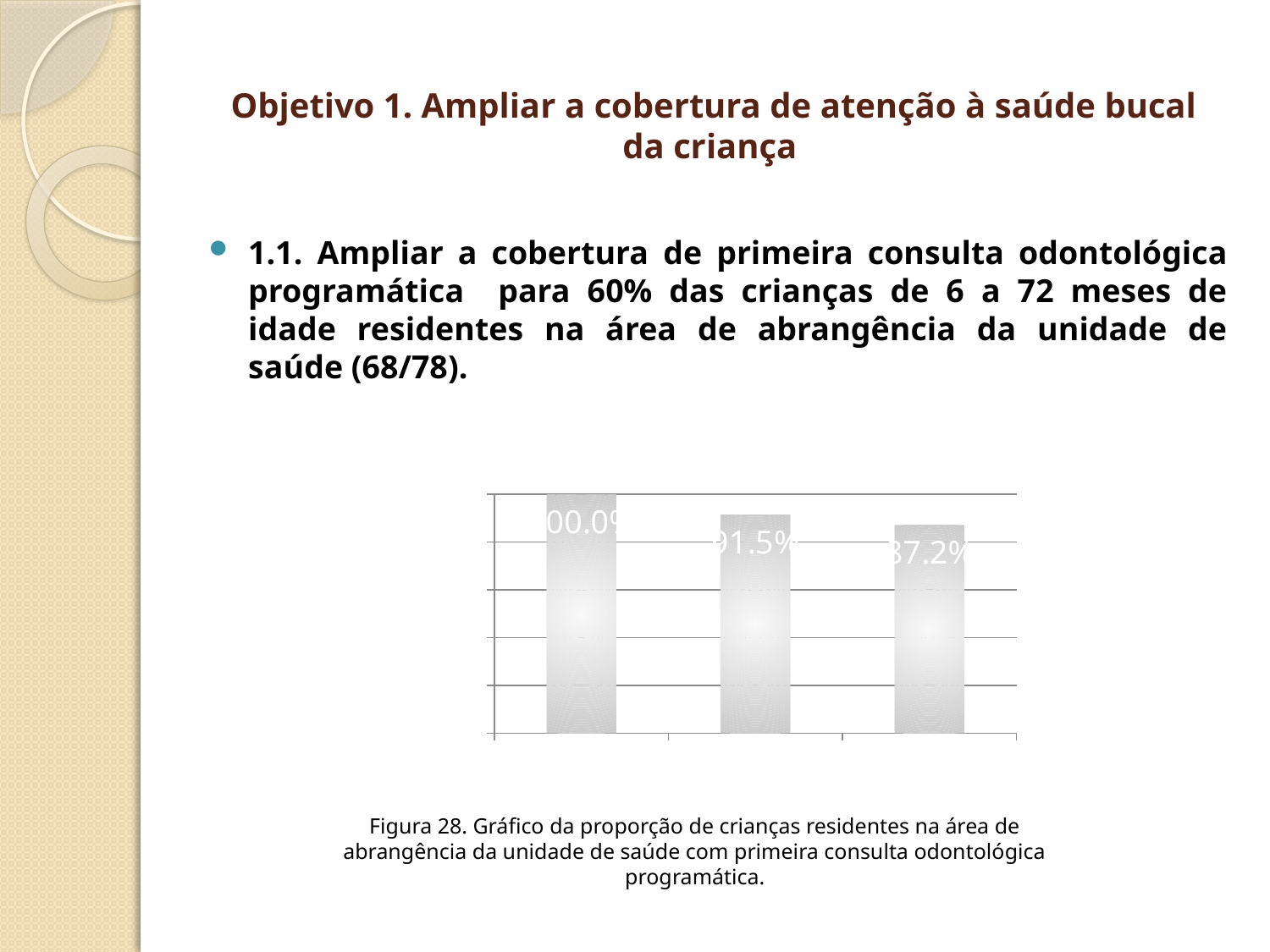
How many bars are plotted in the chart? 3 What figure number is given in the caption below the chart? Figura 28 Which is larger, the value of the first bar or the value of the second bar? the first bar Which is larger, the value of the second bar or the value of the third bar? the second bar What is the difference between the value of the first bar and the value of the second bar? 8.5% Which bar in the chart has the lowest value? the third (rightmost) bar What is the value shown on the first (leftmost) bar of the chart? 100.0% Which bar in the chart has the highest value? the first (leftmost) bar What is the value shown on the second (middle) bar of the chart? 91.5% Do the values in the chart rise or fall from left to right? fall What kind of chart is shown on the slide? bar chart